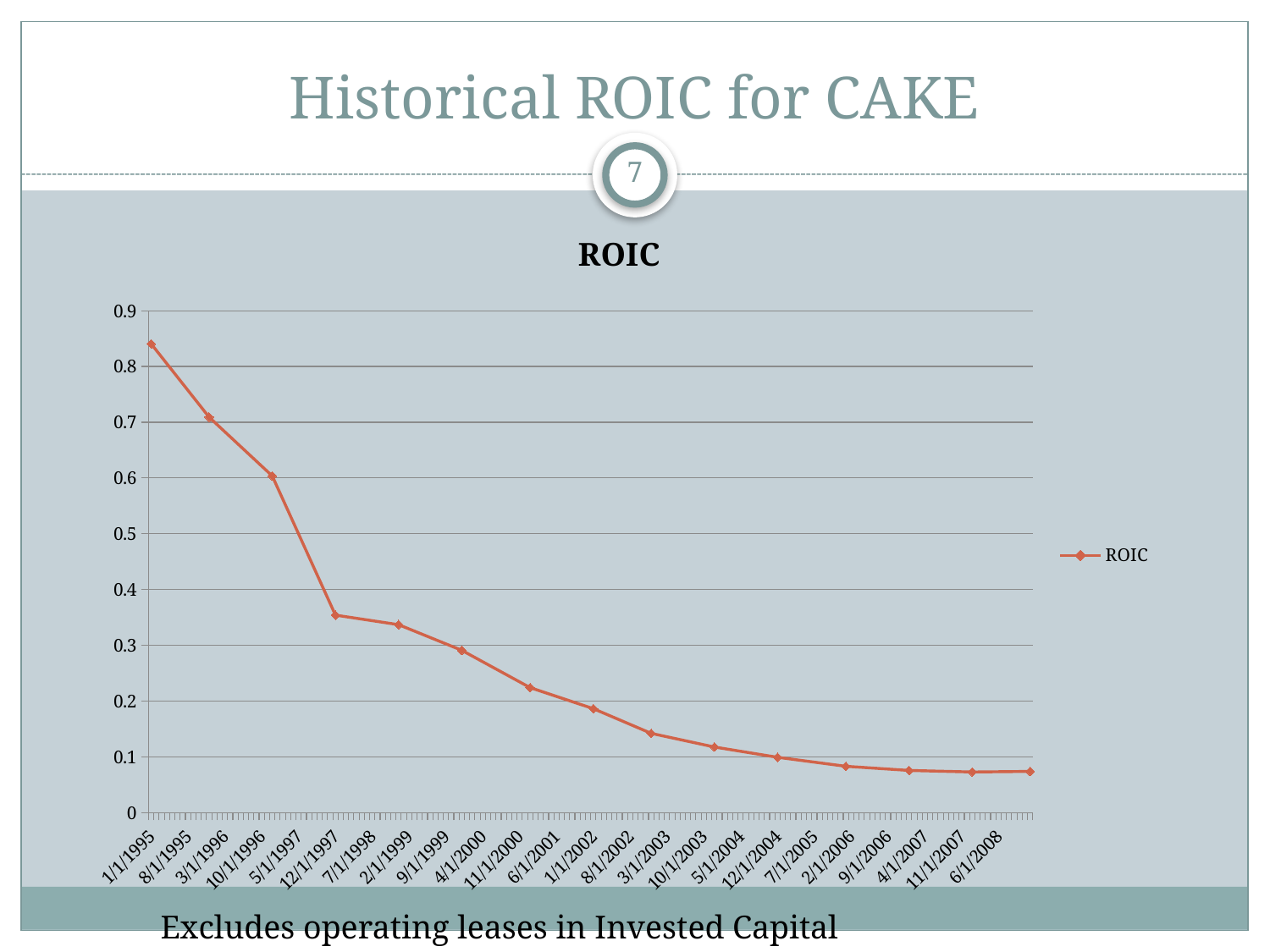
Which is larger, the ROIC value at the first point (1/1/1995) or at the last point on the right? 1/1/1995 Do the ROIC values rise or fall from left to right along the x axis? fall How many data points are plotted on the ROIC line? 15 What is the title of the chart? ROIC Is the ROIC value at 1/1/1995 greater or less than 0.8? greater What kind of chart is shown on the slide? line chart How many series does the legend list? 1 What is the name of the series shown in the legend? ROIC Is the ROIC value at the last point on the right of the chart greater or less than 0.1? less Is the ROIC value at 1/1/1995 greater or less than 0.5? greater At which date is the ROIC value highest? 1/1/1995 What is the highest value shown on the vertical axis? 0.9